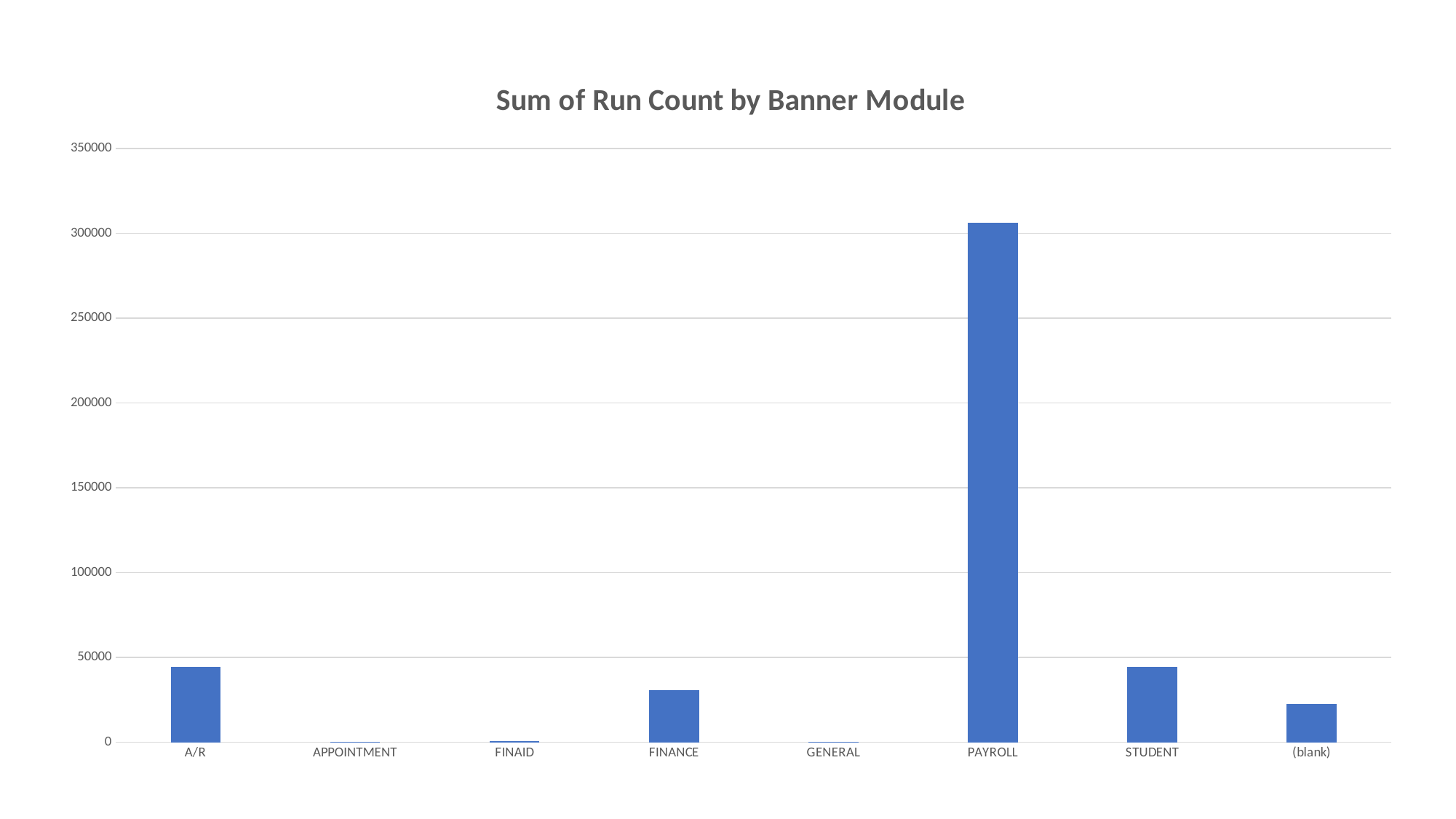
Which has a larger sum of run count, PAYROLL or STUDENT? PAYROLL Is the value for PAYROLL greater or less than 300000? greater Is the value for FINANCE greater or less than 50000? less Is the value for STUDENT greater or less than 100000? less How many Banner Module categories are shown on the x axis? 8 Which Banner Module has the highest sum of run count? PAYROLL What kind of chart is shown on the slide? bar chart Which has a larger sum of run count, FINANCE or (blank)? FINANCE What is the title of the chart? Sum of Run Count by Banner Module Which has a larger sum of run count, A/R or FINAID? A/R